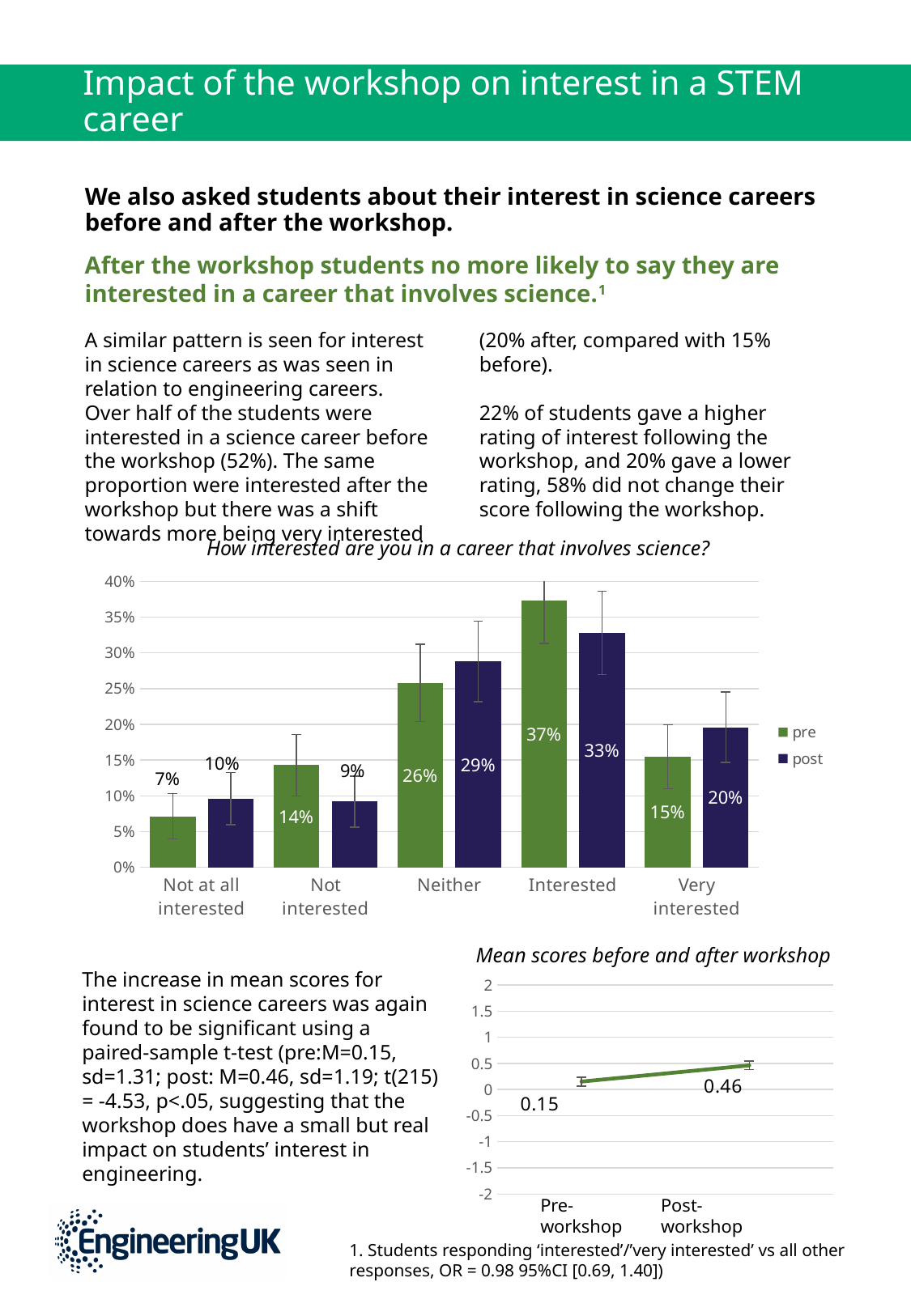
In the chart 'How interested are you in a career that involves science?', which category has the lowest pre value? Not at all interested In the chart 'How interested are you in a career that involves science?', how many series does the legend list? 2 In the chart 'Mean scores before and after workshop', what is the value for Post-workshop? 0.46 In the chart 'How interested are you in a career that involves science?', what is the pre value for 'Interested'? 37% In the chart 'Mean scores before and after workshop', do the values rise or fall from Pre-workshop to Post-workshop? rise What kind of chart is 'How interested are you in a career that involves science?'? bar chart In the chart 'How interested are you in a career that involves science?', which category has the highest pre value? Interested In the chart 'How interested are you in a career that involves science?', what is the post value for 'Not interested'? 9% In the chart 'How interested are you in a career that involves science?', how many categories are shown on the x axis? 5 In the chart 'How interested are you in a career that involves science?', is the pre value or the post value larger for 'Neither'? post In the chart 'How interested are you in a career that involves science?', what is the post value for 'Very interested'? 20% In the chart 'How interested are you in a career that involves science?', what is the difference between the pre and post values for 'Very interested'? 5%